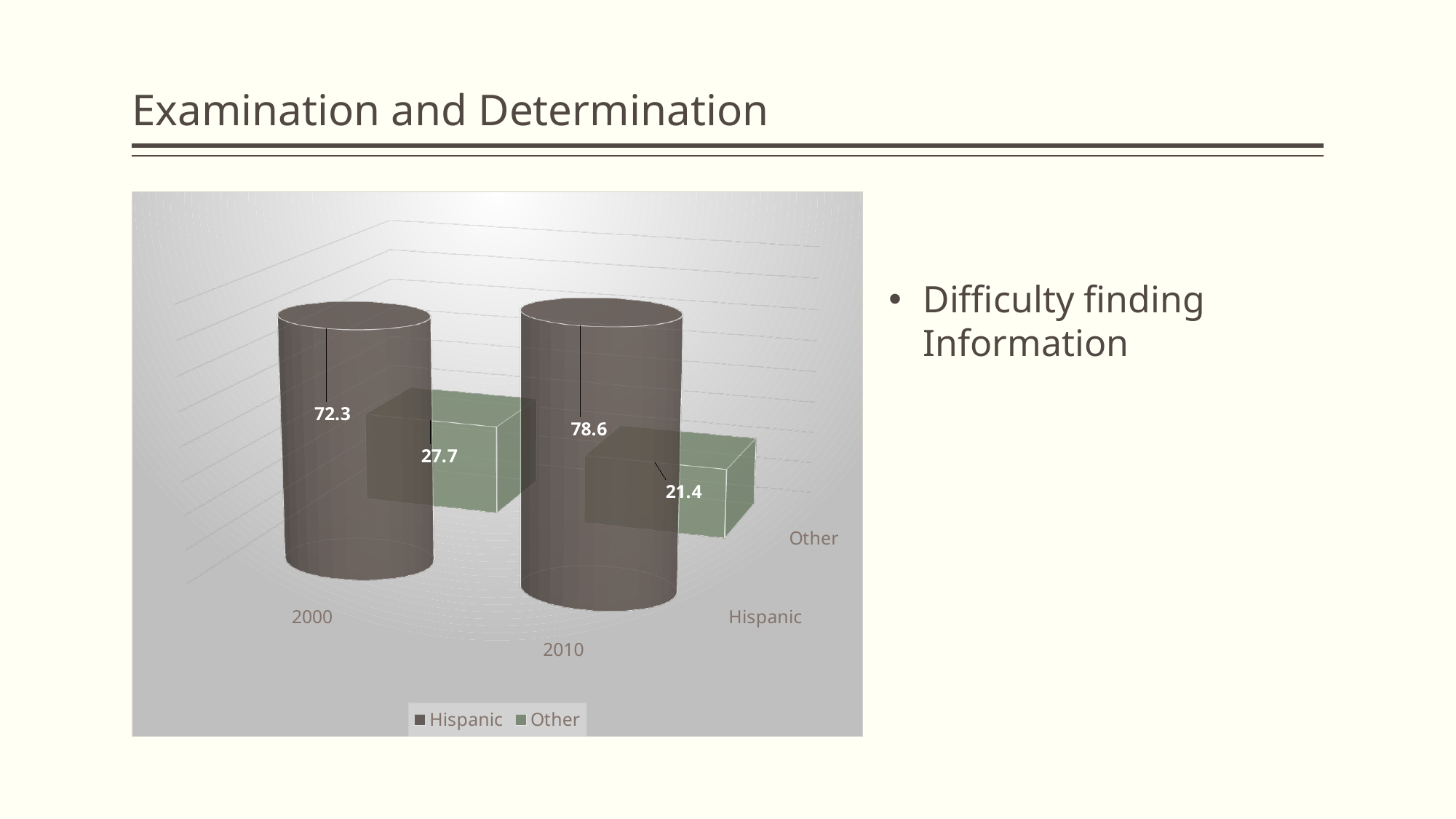
Is the Other value for 2000 larger or smaller than the Other value for 2010? larger What is the value for Hispanic in 2010? 78.6 What is the value for Other in 2010? 21.4 What is the difference between the Hispanic values for 2010 and 2000? 6.3 Which series has the highest value in 2010? Hispanic What is the value for Hispanic in 2000? 72.3 Does the Hispanic series rise or fall from 2000 to 2010? rise What is the value for Other in 2000? 27.7 What kind of chart is shown on the slide? bar chart How many categories are shown on the x axis? 2 Which series has the lowest value in 2000? Other How many series does the legend list? 2